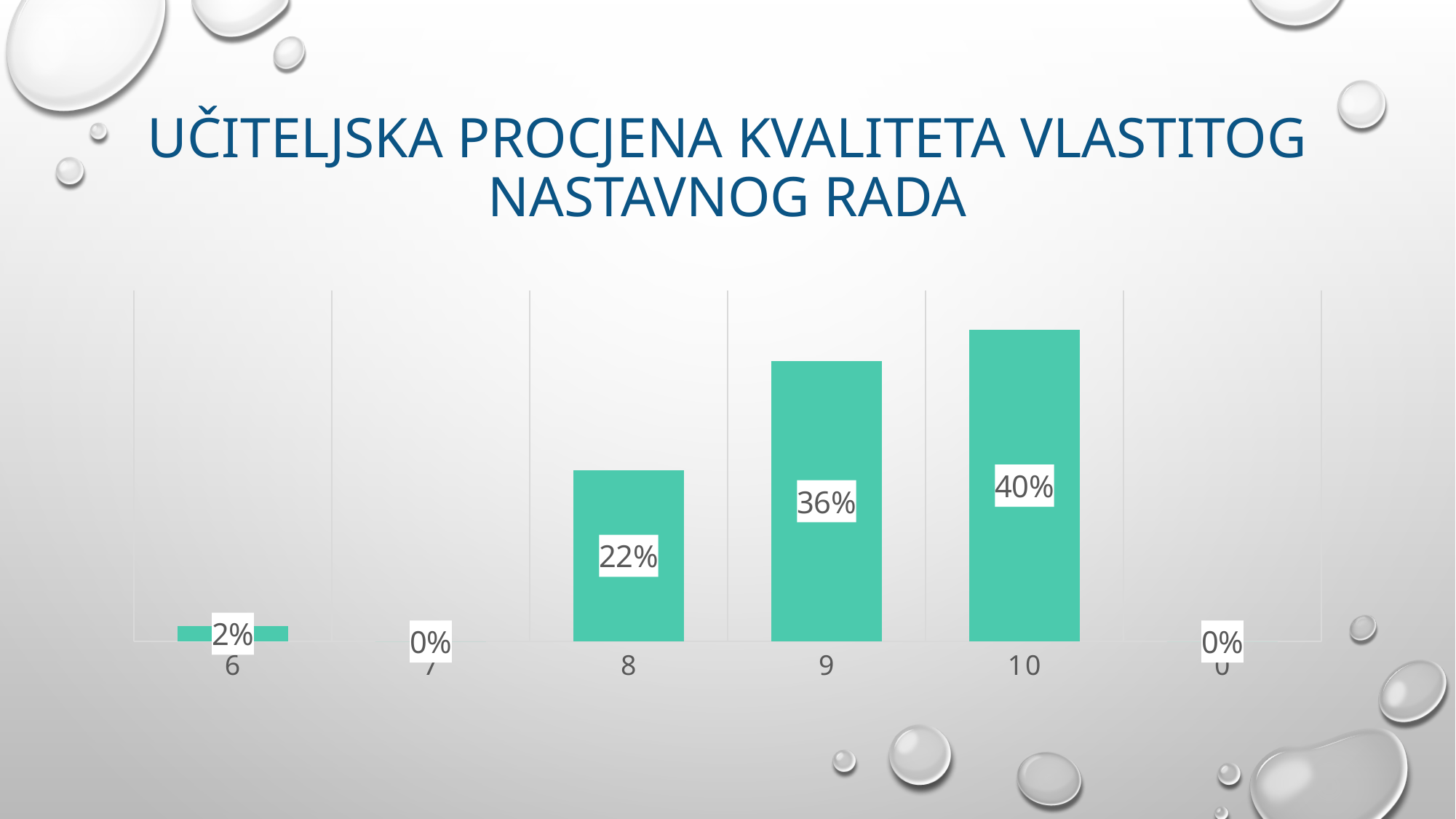
Which is larger, the value for category 8 or the value for category 9? 9 What is the value for category 8? 22% What is the value for category 10? 40% What is the value for category 9? 36% What is the value for category 6? 2% Which category has the highest value? 10 What is the title of the chart on the slide? UČITELJSKA PROCJENA KVALITETA VLASTITOG NASTAVNOG RADA What is the difference between the values for categories 9 and 8? 14% How many categories are shown on the x axis? 6 What kind of chart is shown on the slide? bar chart What is the difference between the values for categories 10 and 9? 4% What is the value for category 7? 0%